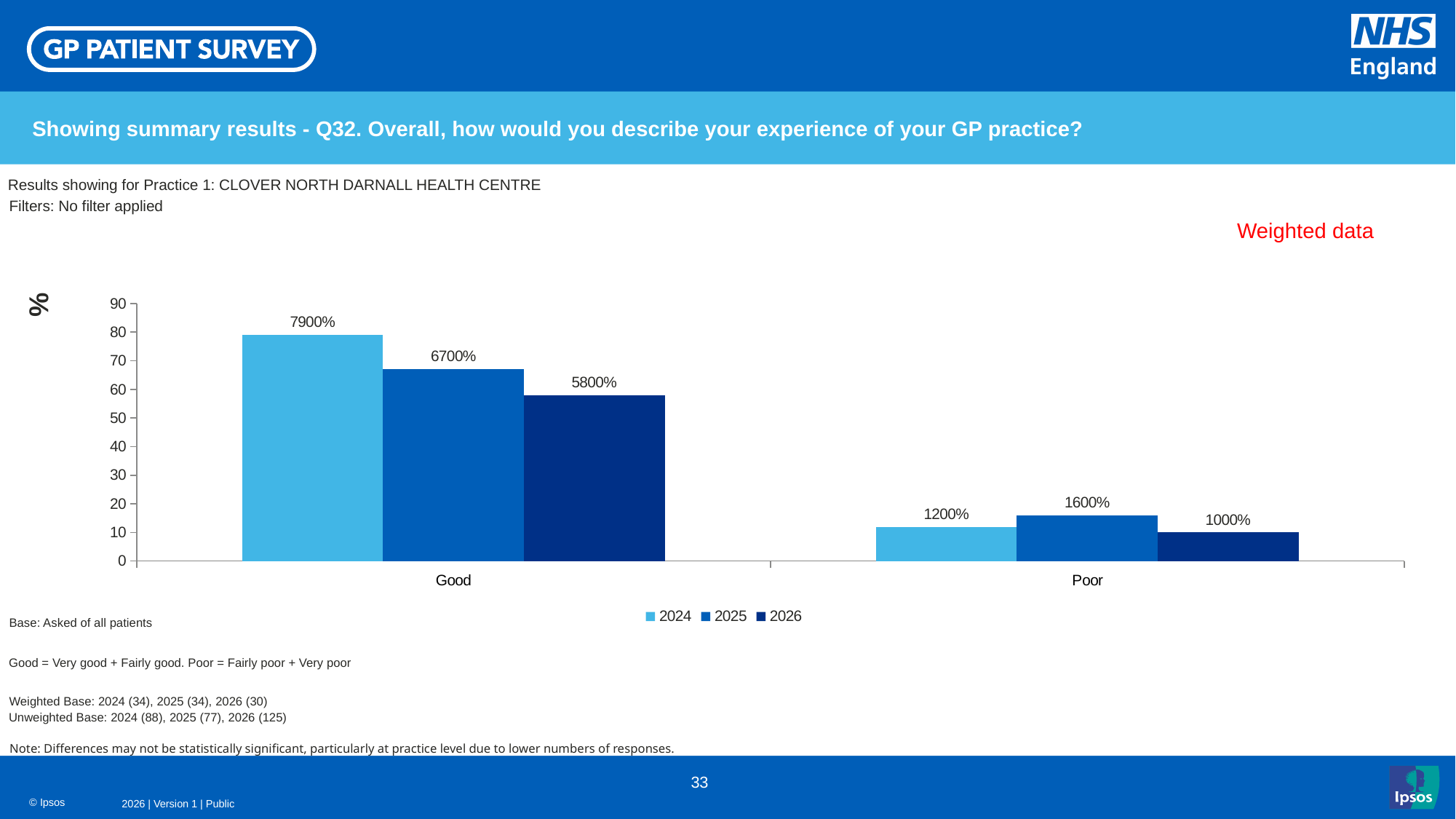
What is the value for Poor in 2026? 1000% Which is larger, the Poor value for 2024 or the Poor value for 2025? 2025 What kind of chart is shown on the slide? Bar chart How many series does the legend list? 3 Which year has the lowest value for Poor? 2026 What is the value for Good in 2024? 7900% What is the difference between the Good values for 2024 and 2025? 1200% What is the value for Poor in 2025? 1600% How many categories are shown on the x axis? 2 Which year has the highest value for Good? 2024 Do the Good values rise or fall from 2024 to 2026? Fall What is the value for Good in 2026? 5800%